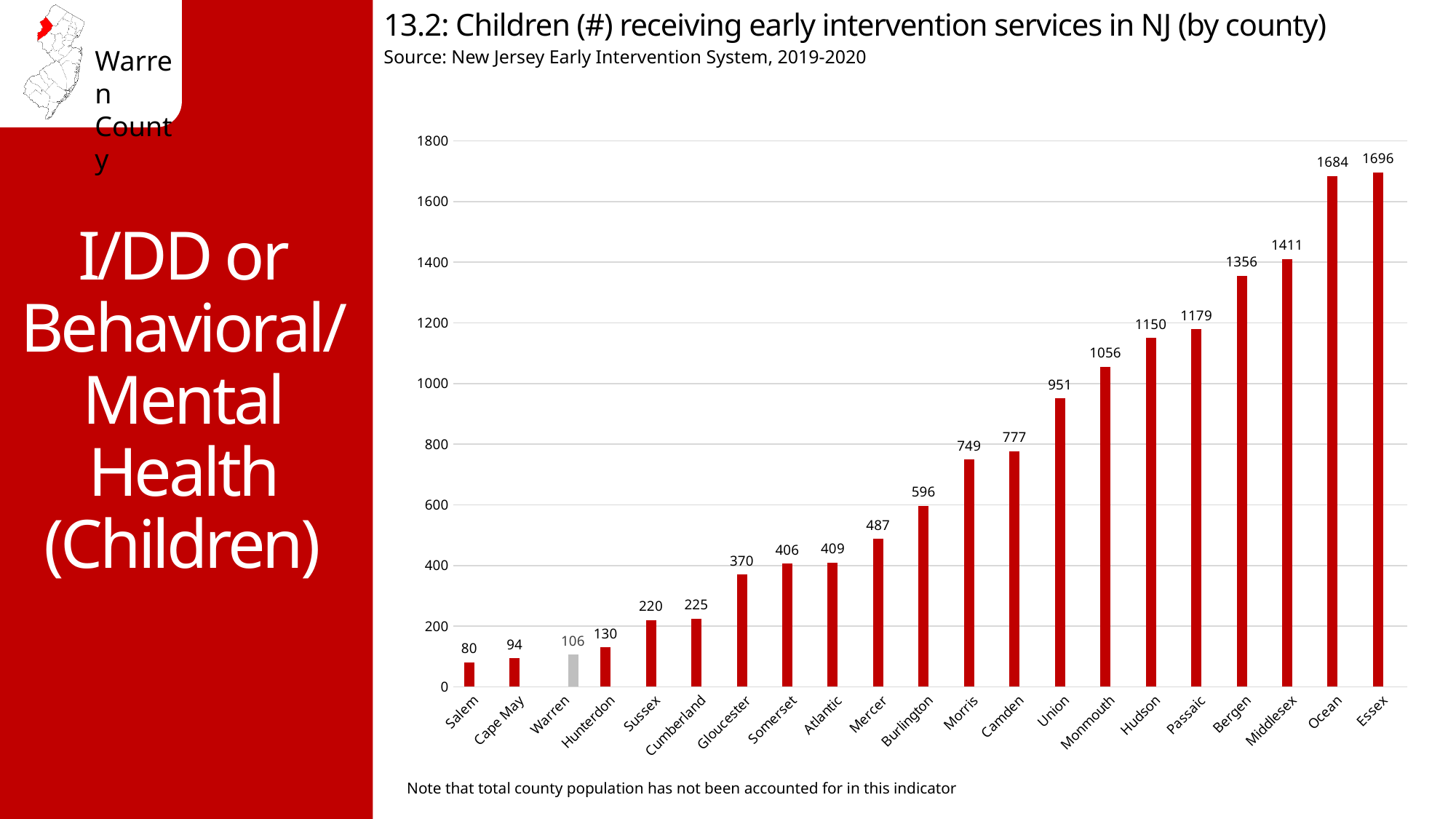
How many counties are shown on the chart? 21 What kind of chart is shown on the slide? Bar chart What is the difference between the values for Warren and Salem? 26 What is the value shown for Mercer County? 487 Which county has the highest number of children receiving early intervention services? Essex What is the difference between the values for Ocean and Middlesex? 273 Is the value for Bergen greater or less than 1200? greater Which county's bar is shown in gray rather than red? Warren How many children are receiving early intervention services in Warren County? 106 What is the value shown for Essex County? 1696 Which county has the lowest number of children receiving early intervention services? Salem Which county has a larger value, Hudson or Union? Hudson